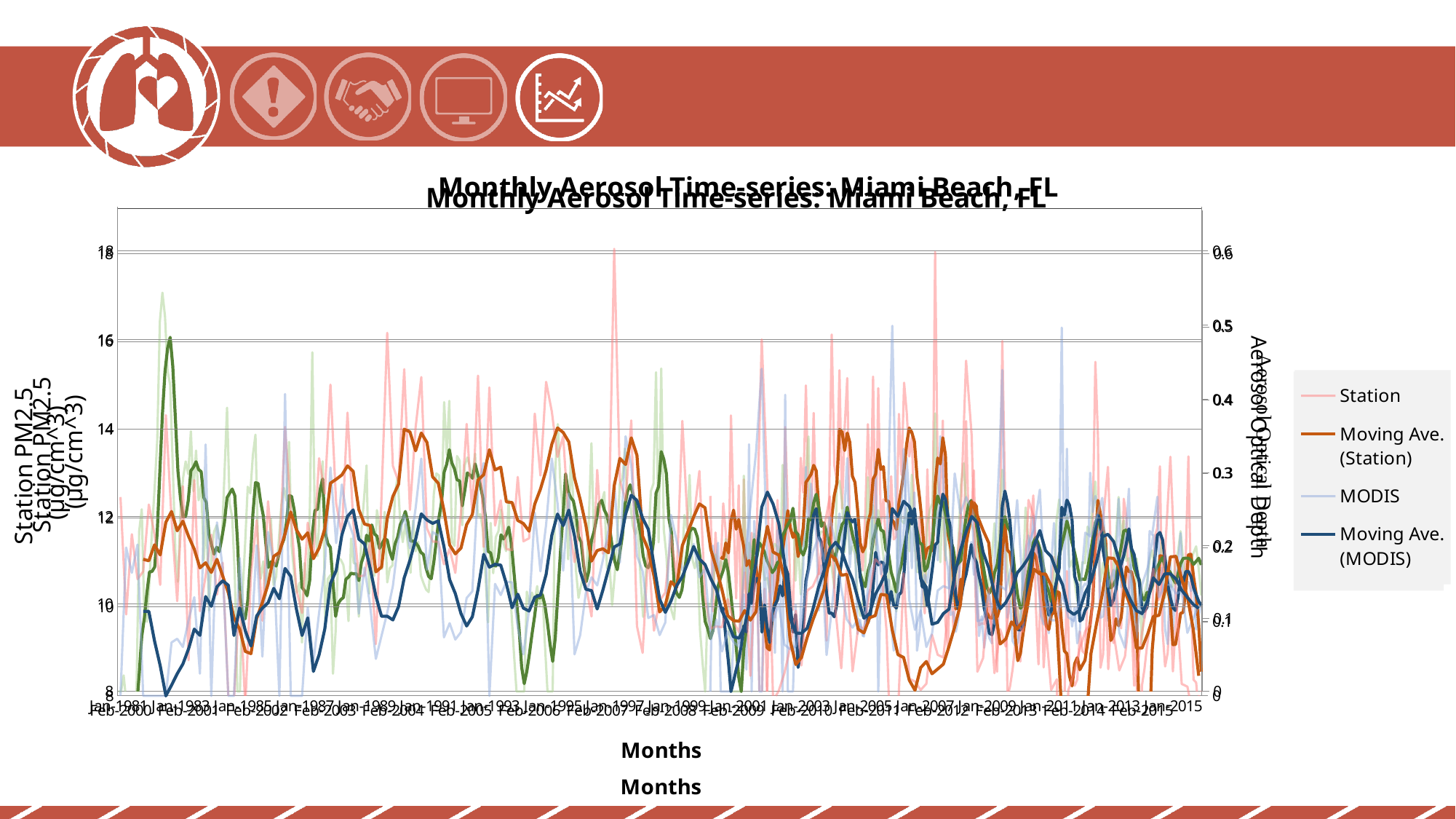
What is the title of the chart? Monthly Aerosol Time-series: Miami Beach, FL What is the highest tick value shown on the right-hand axis (Aerosol Optical Depth)? 0.6 Which series is drawn in dark blue according to the legend? Moving Ave. (MODIS) Is the peak of the Moving Ave. (Station) line greater or less than 16 on the left axis? less How many series does the legend list? 4 Is the peak of the Moving Ave. (MODIS) line greater or less than 0.4 on the right axis? less What kind of chart is shown on the slide? Line chart What is the label of the x axis? Months What is the lowest tick value shown on the left-hand axis (Station PM2.5)? 8